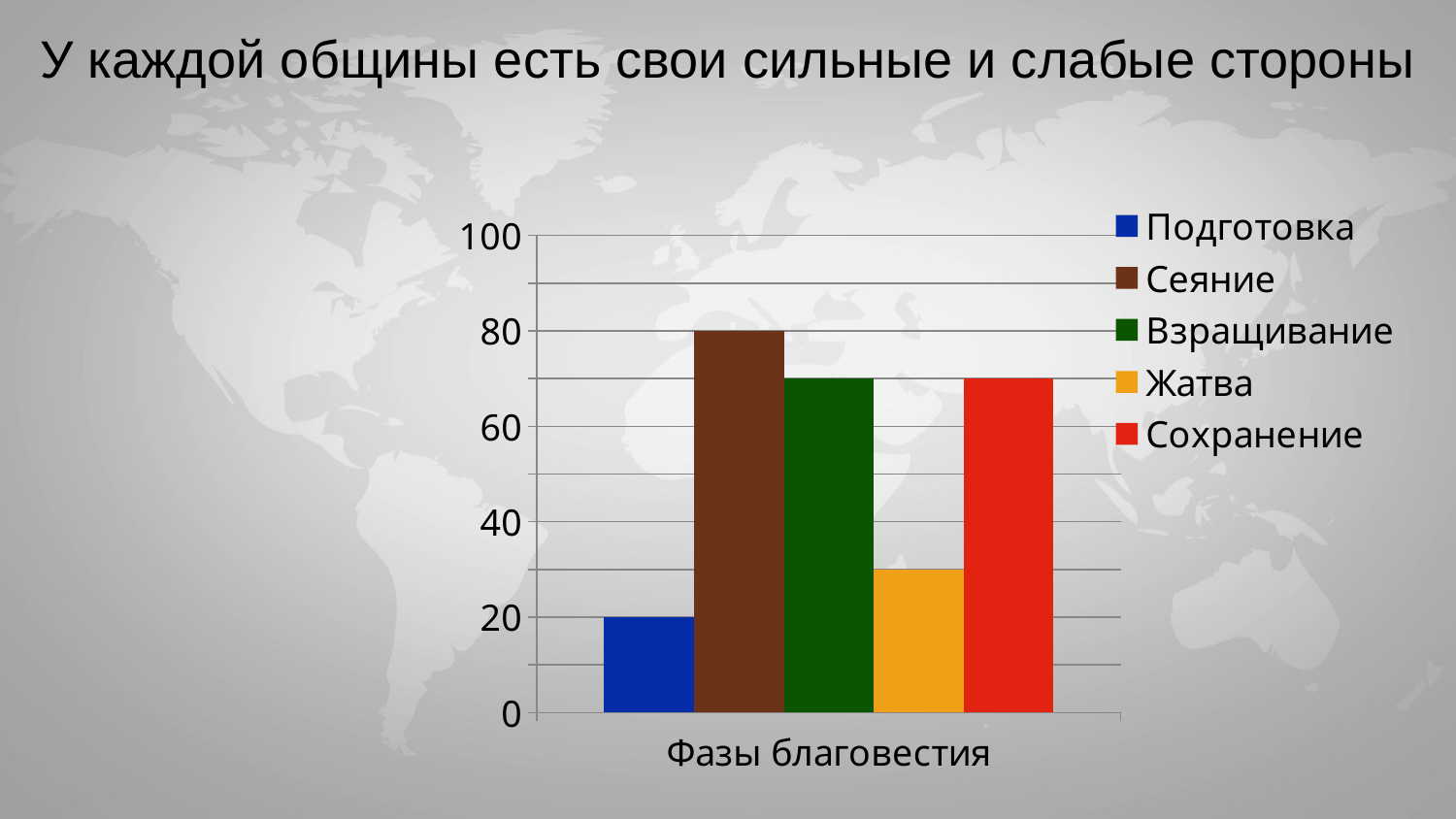
Which is larger, the value for Сеяние or the value for Жатва? Сеяние How many series does the legend list? 5 Which series has the highest bar? Сеяние Is the value for Жатва greater or less than 40? less What kind of chart is shown on the slide? bar chart Which series has the lowest bar? Подготовка Is the value for Взращивание greater or less than 60? greater What is the difference between the values for Сеяние and Подготовка? 60 What is the label on the x axis of the chart? Фазы благовестия What is the value for Подготовка? 20 Is the value for Сохранение greater or less than 80? less What is the value for Сеяние? 80